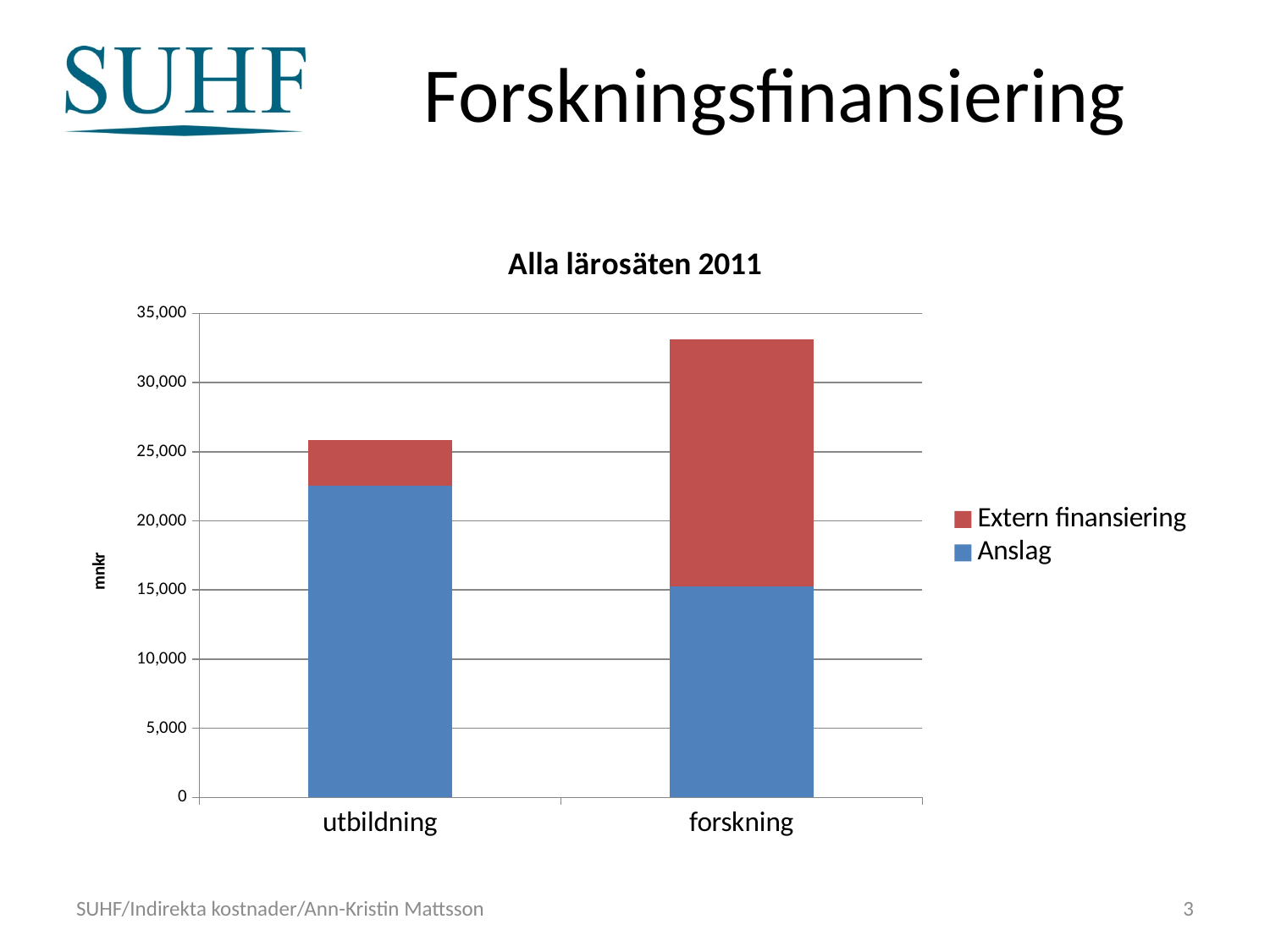
Is the total bar for forskning greater or less than 30,000? greater Which category has the larger Extern finansiering value? forskning Which category has the larger Anslag value? utbildning What unit is shown on the y axis label? mnkr Is the Anslag value for utbildning greater or less than 20,000? greater Which category has the taller total bar, utbildning or forskning? forskning Is the total bar for utbildning greater or less than 30,000? less How many series does the legend list? 2 What kind of chart is shown on the slide? stacked bar chart How many categories are shown on the x axis? 2 What is the title of the chart? Alla lärosäten 2011